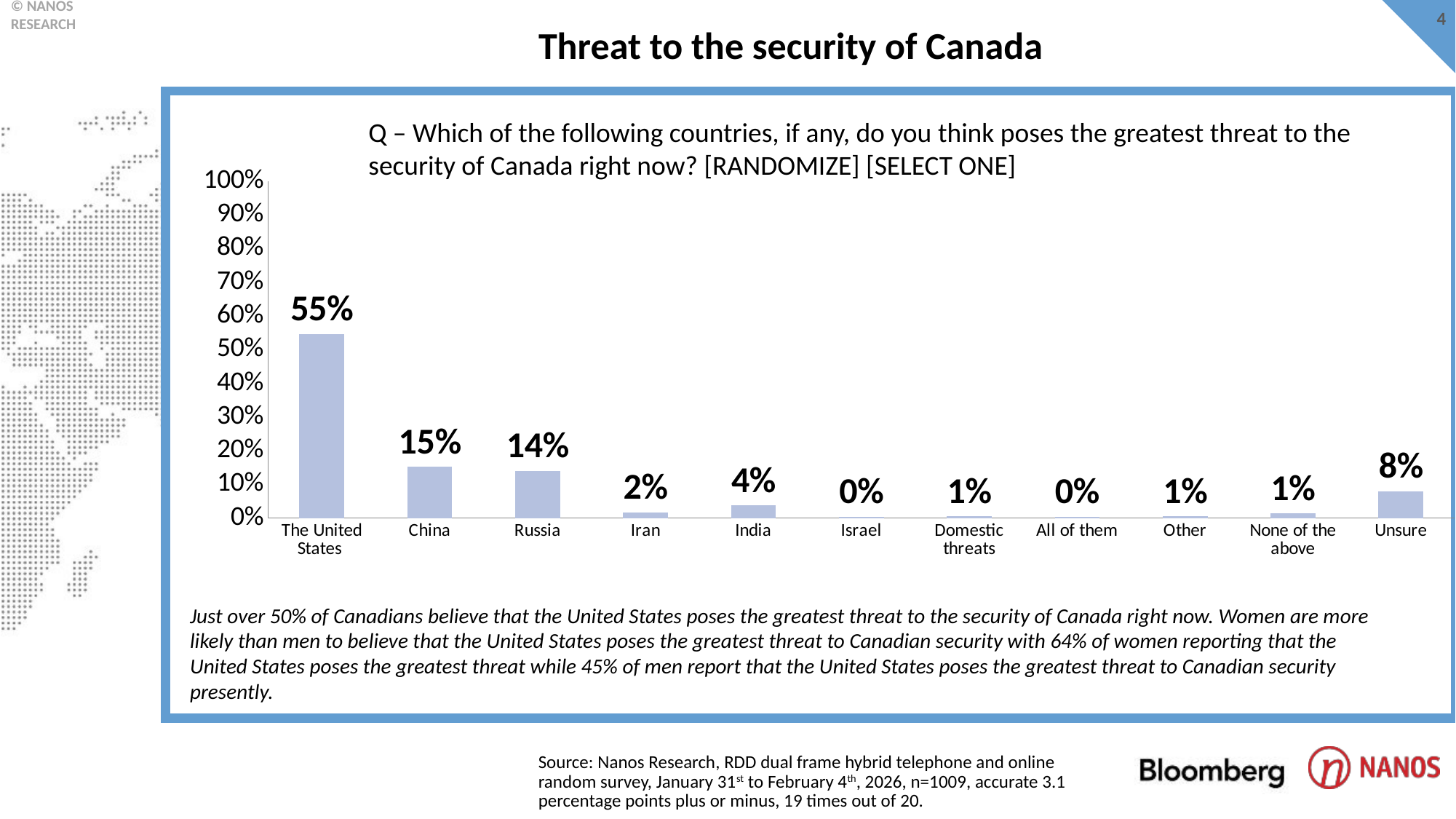
What is the title of the slide? Threat to the security of Canada What kind of chart is shown on the slide? Bar chart What is the difference between the values for the United States and China? 40 percentage points What percentage of respondents said the United States poses the greatest threat to the security of Canada? 55% What is the value shown for India? 4% What is the value shown for Unsure? 8% Is the value for the United States greater or less than 50%? greater What is the value shown for China? 15% How many categories are shown on the x axis? 11 Which has a larger value, China or Russia? China What is the difference between the values for Russia and Iran? 12 percentage points Which category has the highest value? The United States